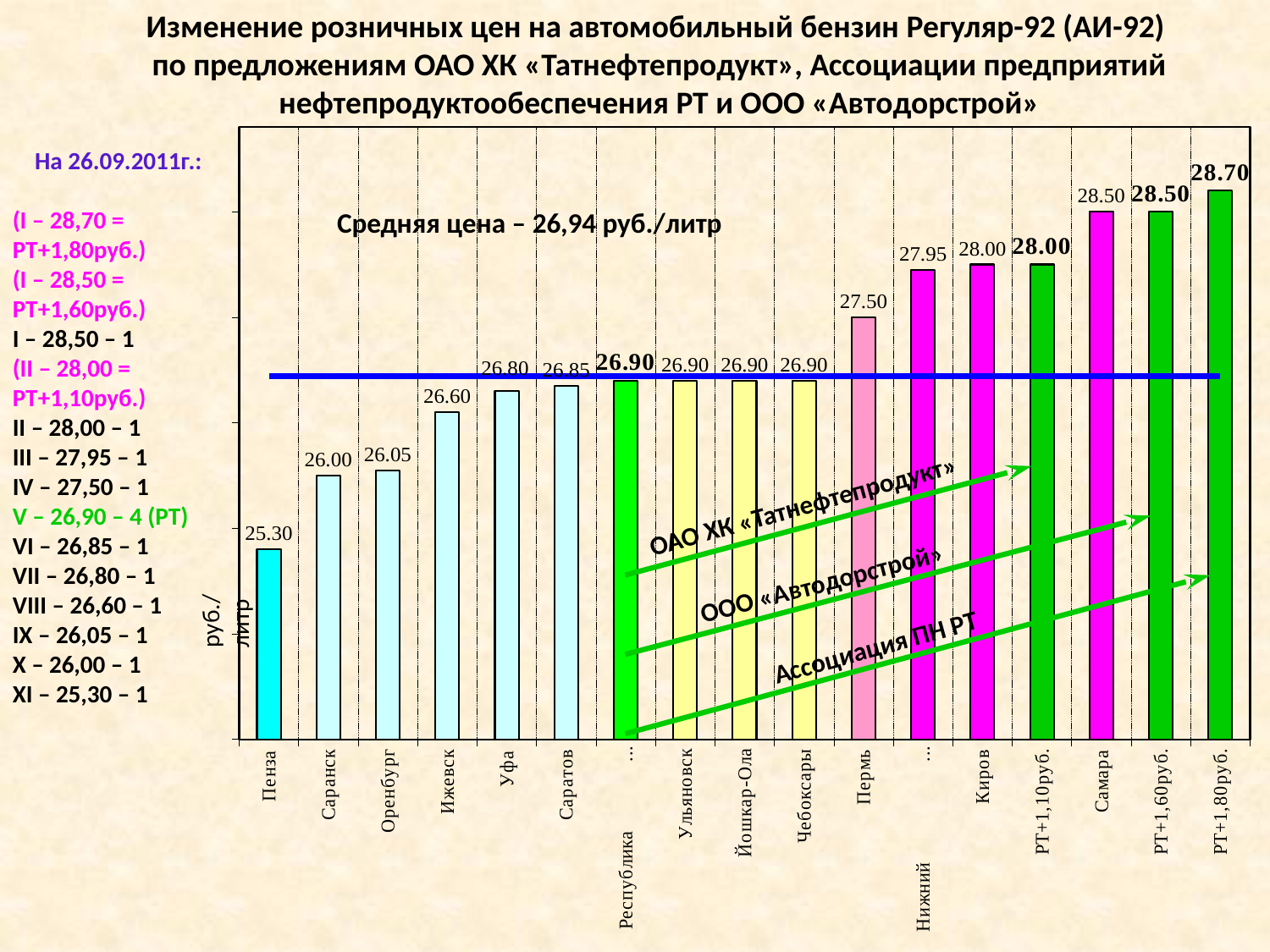
What is the value for Самара? 28.50 How many bars are plotted in the chart? 17 What is the difference between the values for Киров and Пенза? 2.70 Which category has the highest value? РТ+1,80руб. What is the value for Пермь? 27.50 Which is larger, the value for Уфа or the value for Саранск? Уфа Which category has the lowest value? Пенза What average price is stated on the chart? 26,94 руб./литр What is the value for Ижевск? 26.60 Do the values generally rise or fall from left to right along the x axis? rise What kind of chart is shown on the slide? bar chart What is the value for Пенза? 25.30